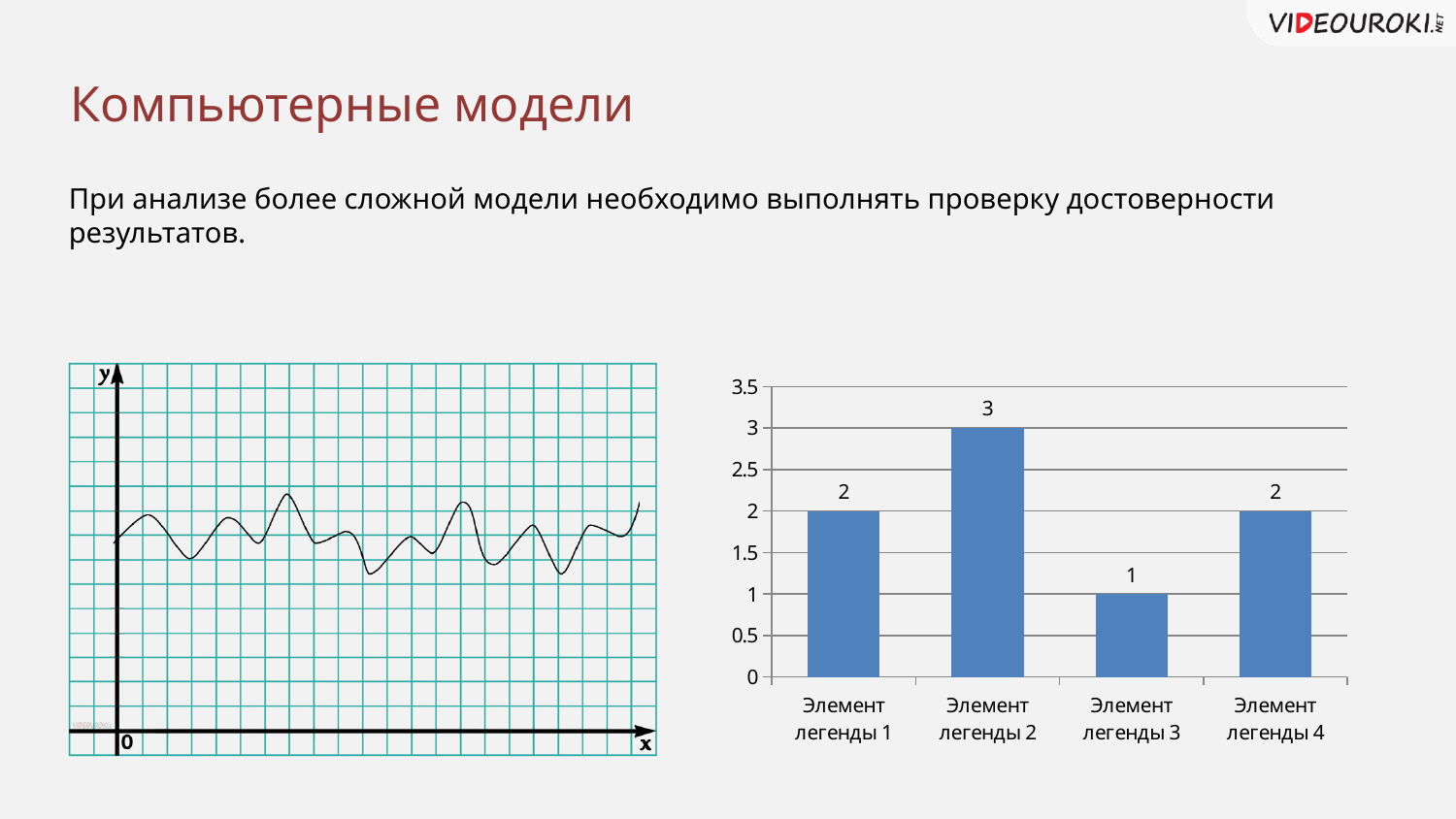
On the bar chart on the right, which category has the highest value? Элемент легенды 2 On the bar chart on the right, which category has the lowest value? Элемент легенды 3 On the bar chart on the right, what is the value for Элемент легенды 3? 1 On the bar chart on the right, what is the value for Элемент легенды 2? 3 On the bar chart on the right, is the value for Элемент легенды 2 greater or less than 2.5? greater On the bar chart on the right, what is the highest value shown on the vertical axis? 3.5 How many categories are shown on the bar chart on the right? 4 On the bar chart on the right, what is the difference between the values for Элемент легенды 2 and Элемент легенды 3? 2 What kind of chart is shown on the right side of the slide? bar chart On the bar chart on the right, which is larger: the value for Элемент легенды 1 or Элемент легенды 2? Элемент легенды 2 On the bar chart on the right, what is the value for Элемент легенды 1? 2